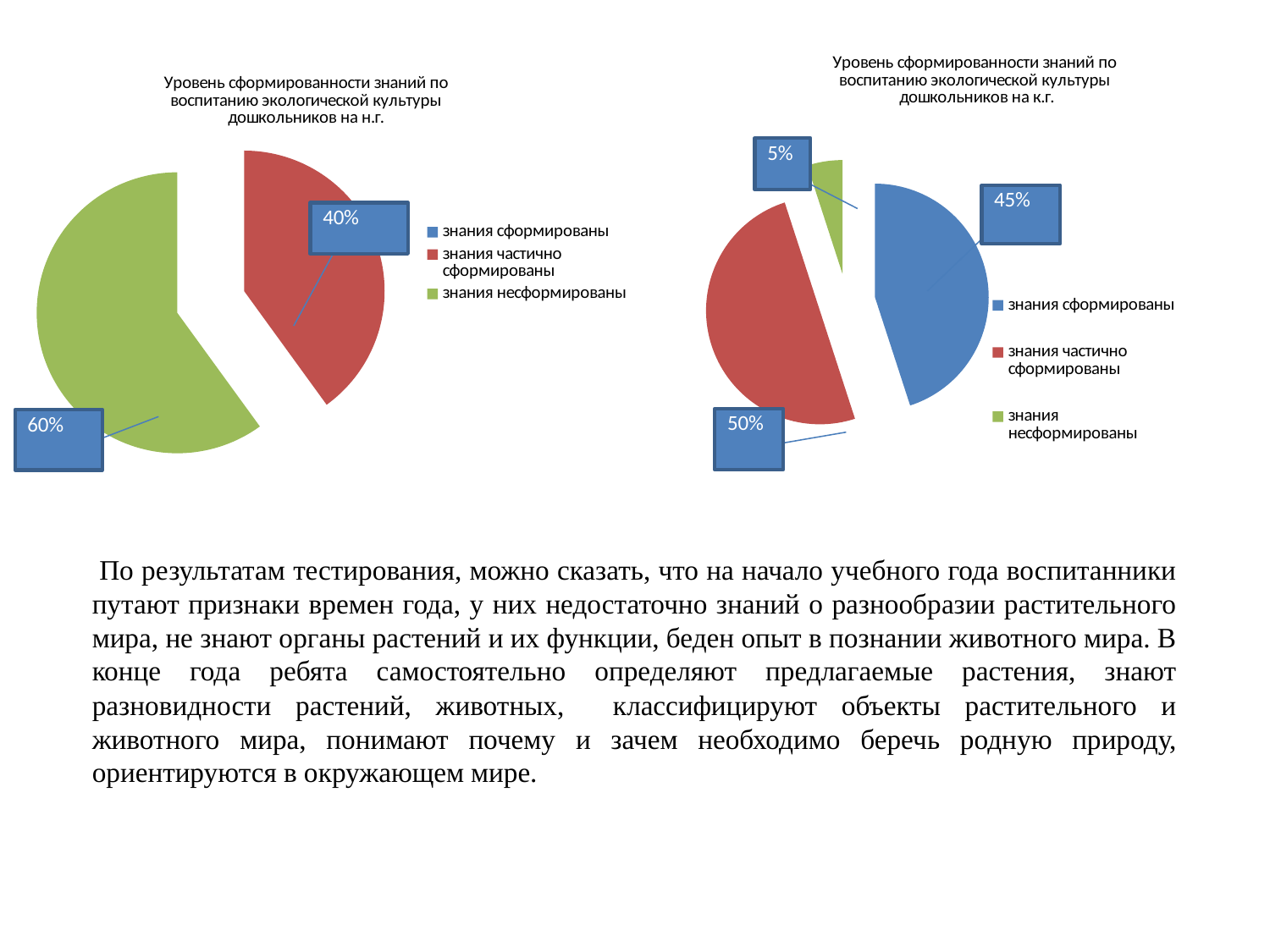
In the right chart (на к.г.), what percentage is shown for «знания частично сформированы»? 50% In the right chart (на к.г.), what percentage is shown for «знания несформированы»? 5% In the left chart (на н.г.), what percentage is shown for «знания частично сформированы»? 40% In the right chart (на к.г.), what percentage is shown for «знания сформированы»? 45% How many entries does the legend of the right chart (на к.г.) list? 3 In the right chart (на к.г.), which category has the largest slice? знания частично сформированы In the left chart (на н.г.), what percentage is shown for «знания несформированы»? 60% In the right chart (на к.г.), by how many percentage points does «знания частично сформированы» exceed «знания сформированы»? 5 percentage points In the right chart (на к.г.), which category has the smallest slice? знания несформированы What type of chart is used on this slide? Pie chart In the left chart (на н.г.), which category has the largest slice? знания несформированы In the left chart (на н.г.), by how many percentage points does «знания несформированы» exceed «знания частично сформированы»? 20 percentage points